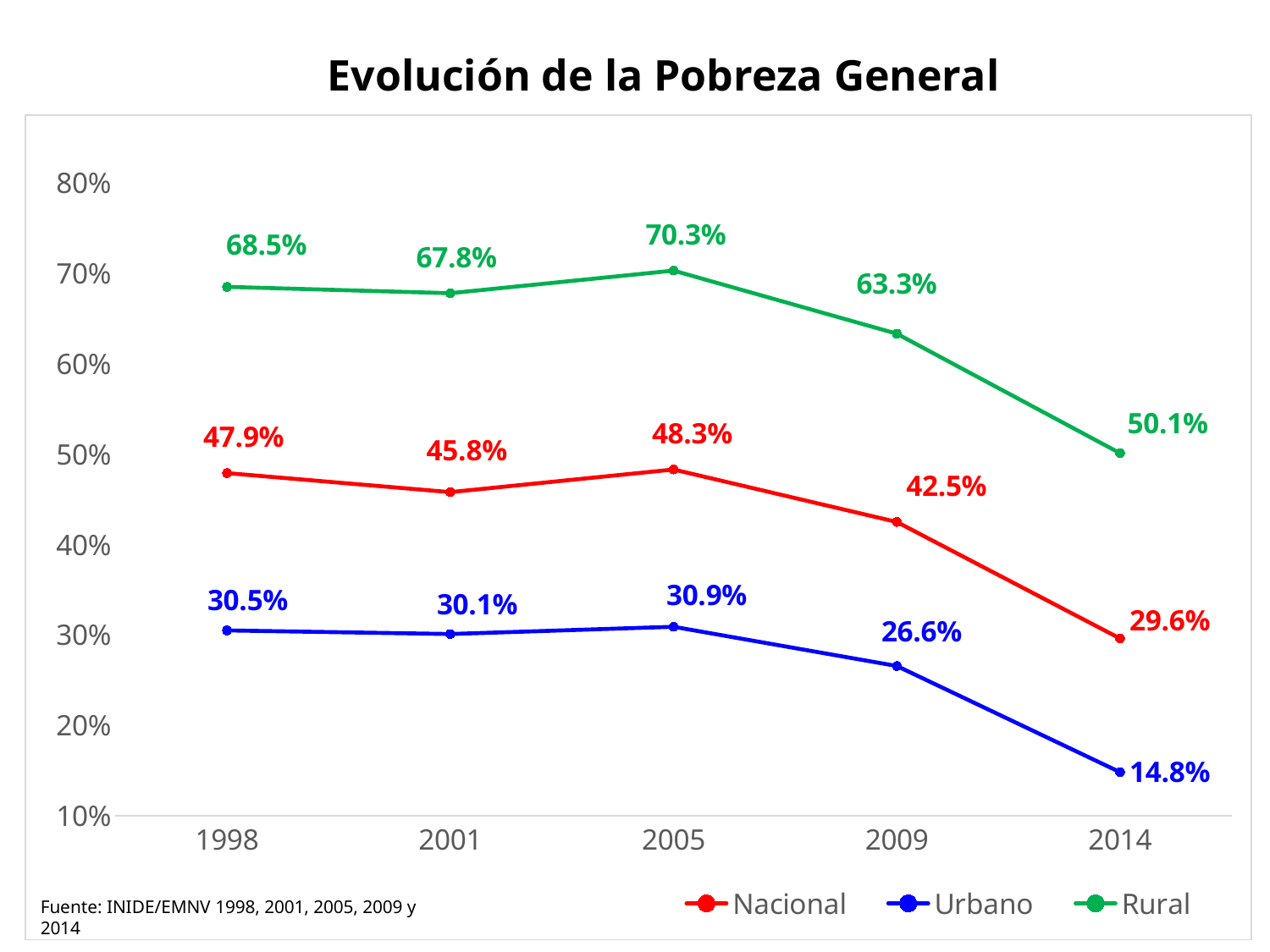
In which year is the Nacional series at its lowest? 2014 What is the Nacional value in 2009? 42.5% How many years are shown on the x axis? 5 How many series does the legend list? 3 What kind of chart is this? line chart What is the Urbano value in 2014? 14.8% In which year is the Rural series at its highest? 2005 Does the Rural series rise or fall between 2005 and 2014? fall Which is larger, the Urbano value in 2005 or the Urbano value in 2009? 2005 By how much did the Nacional value fall from 2009 to 2014? 12.9% What is the difference between the Rural and Urbano values in 1998? 38.0% What is the Rural poverty rate in 2005? 70.3%